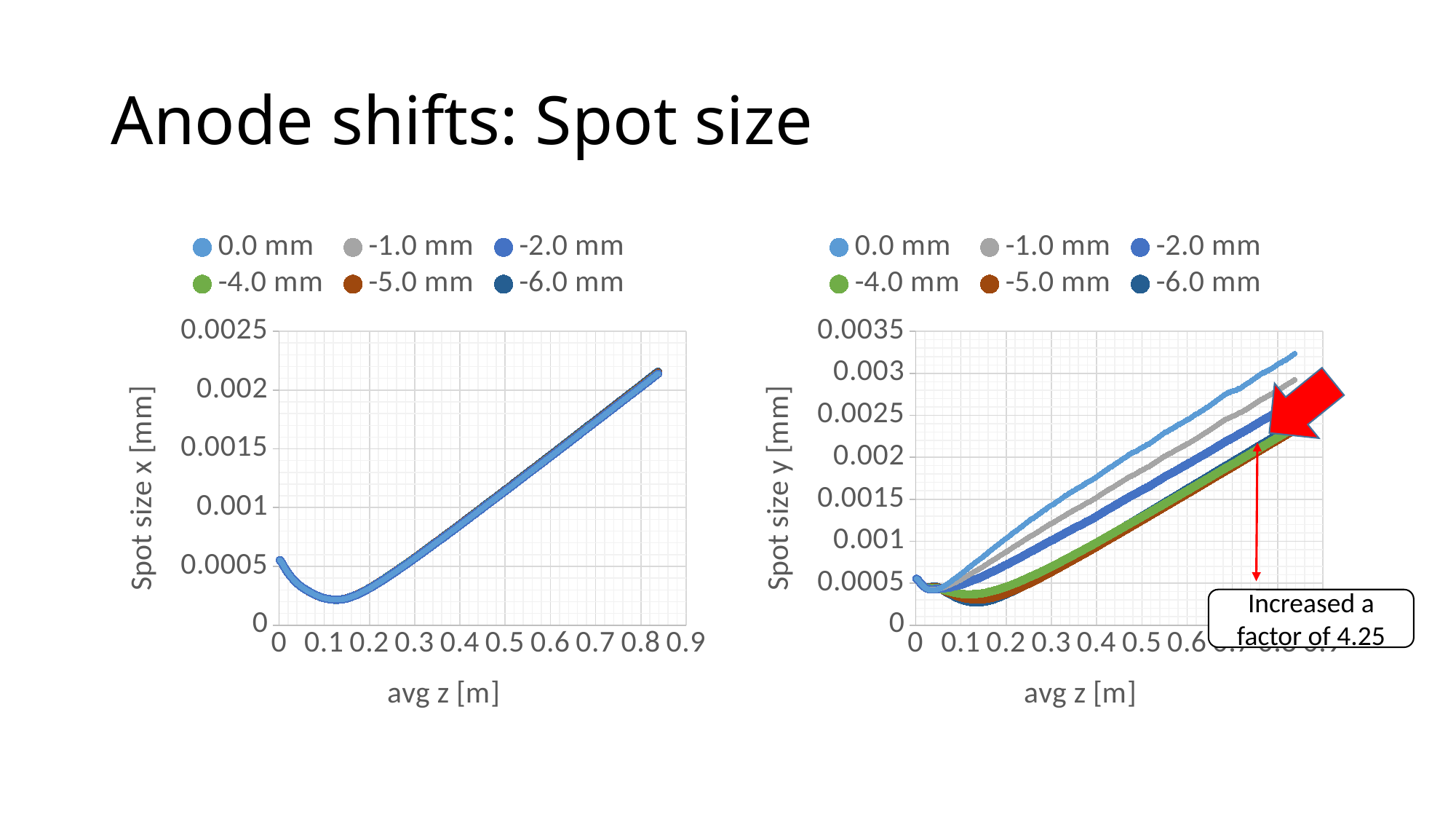
On the left chart (Spot size x), is the minimum value of the curves greater or less than 0.0005? less What kind of chart is the left chart (Spot size x)? line chart On the right chart (Spot size y), which series reaches the highest spot size at the right end of the x axis? 0.0 mm On the right chart (Spot size y), at the right end of the curves, which is larger: the 0.0 mm series or the -6.0 mm series? 0.0 mm On the left chart (Spot size x), how many series does the legend list? 6 What does the text box annotation on the right chart say? Increased a factor of 4.25 What is the y-axis title of the left chart? Spot size x [mm] On the left chart (Spot size x), do the values rise or fall as avg z increases from 0.2 to 0.8? rise On the right chart (Spot size y), is the value of the -1.0 mm series at the right end of the curve greater or less than 0.0025? greater On the right chart (Spot size y), is the value of the 0.0 mm series at the right end of the curve greater or less than 0.003? greater On the right chart (Spot size y), how many series does the legend list? 6